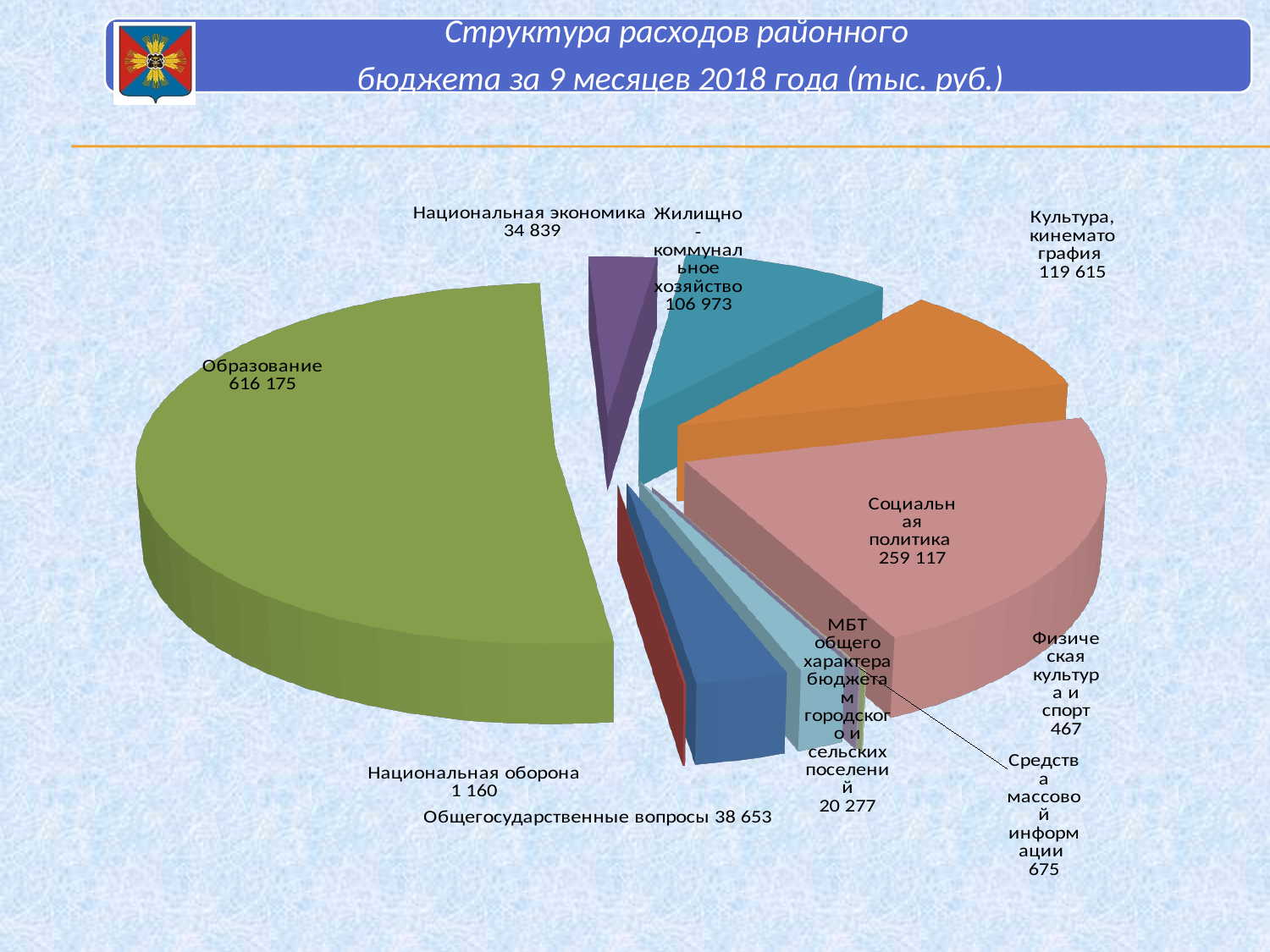
What is the value for Образование? 616 175 What is the value for Национальная оборона? 1 160 Which category has the smallest value? Физическая культура и спорт What is the value for Средства массовой информации? 675 Which is larger: Общегосударственные вопросы or Национальная экономика? Общегосударственные вопросы What is the value for Социальная политика? 259 117 What is the difference between Культура, кинематография and Жилищно-коммунальное хозяйство? 12 642 What is the difference between Образование and Социальная политика? 357 058 How many categories does the pie chart show? 10 What type of chart is shown on the slide? Pie chart Which category has the largest share of expenditures? Образование What is the value for Жилищно-коммунальное хозяйство? 106 973